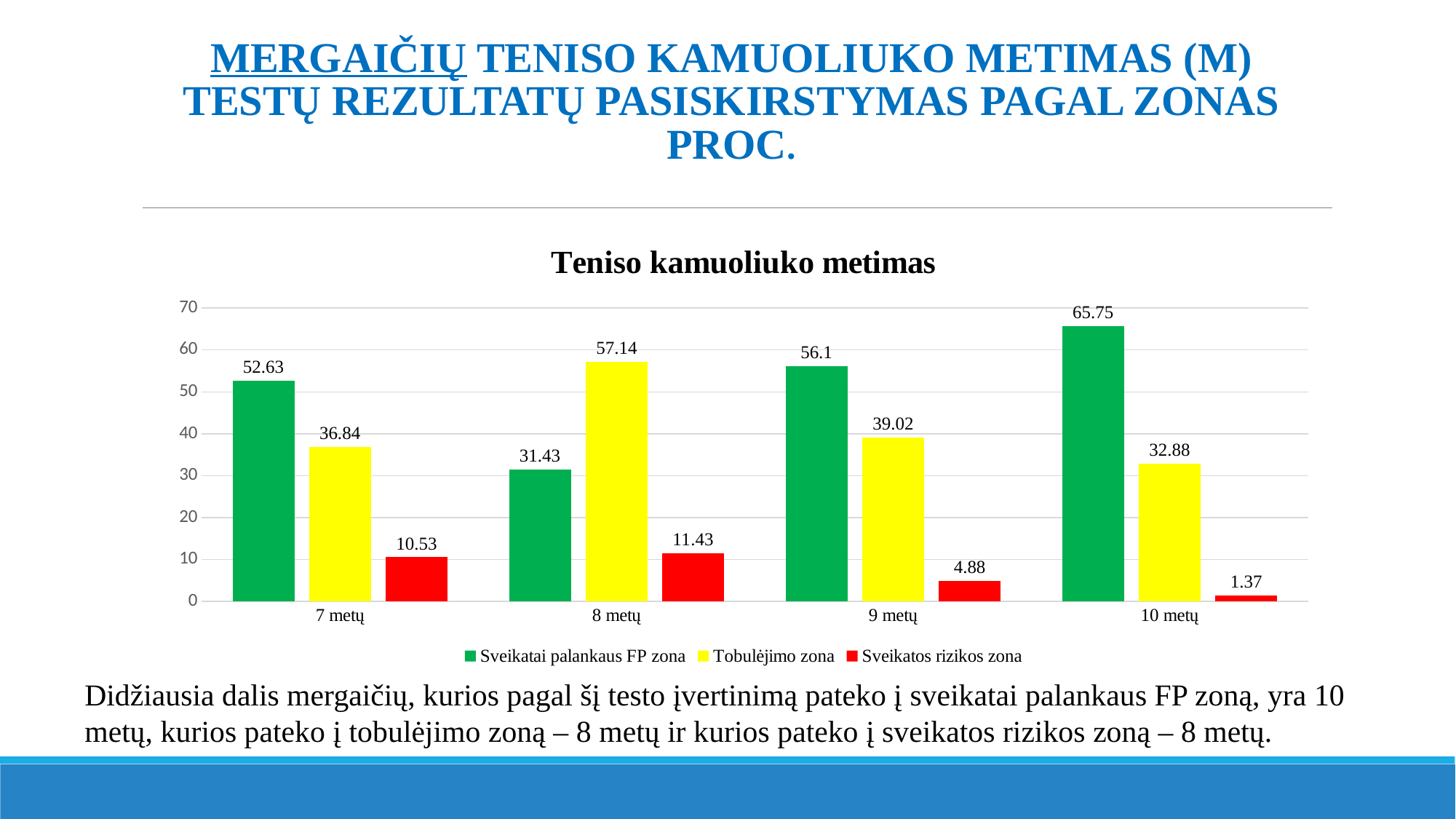
Which is larger for 9 metų: Sveikatai palankaus FP zona or Tobulėjimo zona? Sveikatai palankaus FP zona How many age groups are shown on the x axis? 4 What is the difference between the Sveikatai palankaus FP zona values for 10 metų and 7 metų? 13.12 What is the title of the chart? Teniso kamuoliuko metimas Which age group has the lowest value for Sveikatos rizikos zona? 10 metų What is the value for Tobulėjimo zona for 8 metų? 57.14 Is the value for Tobulėjimo zona for 10 metų greater or less than 40? less How many series does the legend list? 3 What is the value for Sveikatos rizikos zona for 10 metų? 1.37 Which age group has the highest value for Sveikatai palankaus FP zona? 10 metų What is the value for Sveikatai palankaus FP zona for 7 metų? 52.63 What kind of chart is shown? bar chart